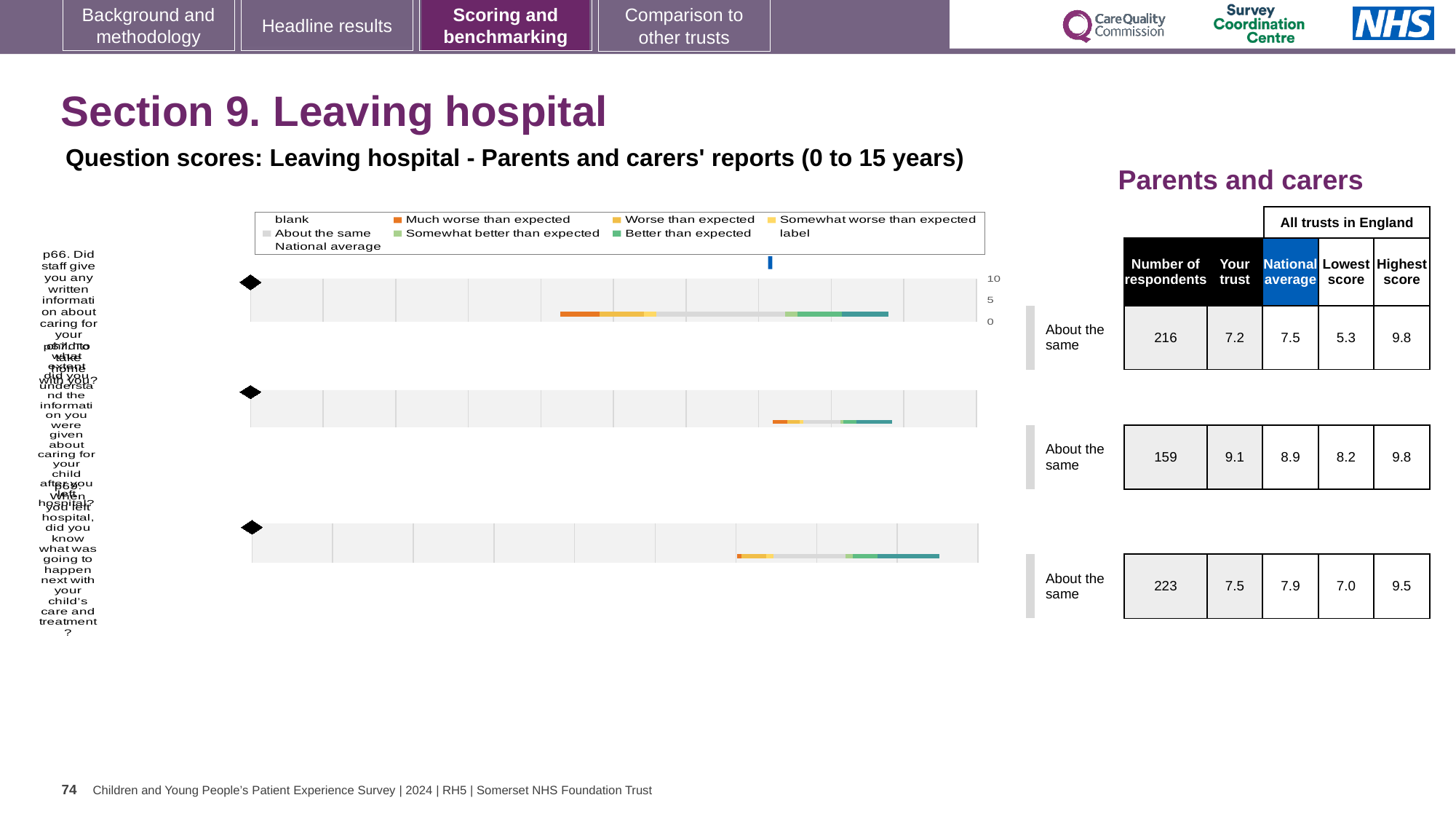
What is the highest tick value shown on the score axis of the top chart? 10 For the second question (159 respondents), what is the difference between the highest score and the lowest score? 1.6 How many separate benchmark bar charts are shown on the slide? 3 In the table next to the charts, what is the national average for the second question (159 respondents)? 8.9 In the table next to the charts, what is the highest score for the third question (223 respondents)? 9.5 What colour does the legend use for 'Much worse than expected'? orange In the table next to the charts, what is the 'Your trust' score for the first question (216 respondents)? 7.2 How many entries does the legend above the charts list? 9 For the second question (159 respondents), which is larger: the 'Your trust' score or the national average? Your trust What kind of chart is used to show the question scores on this slide? bar chart How many respondents answered the third question in the table? 223 What benchmark category is shown beside each of the three charts? About the same